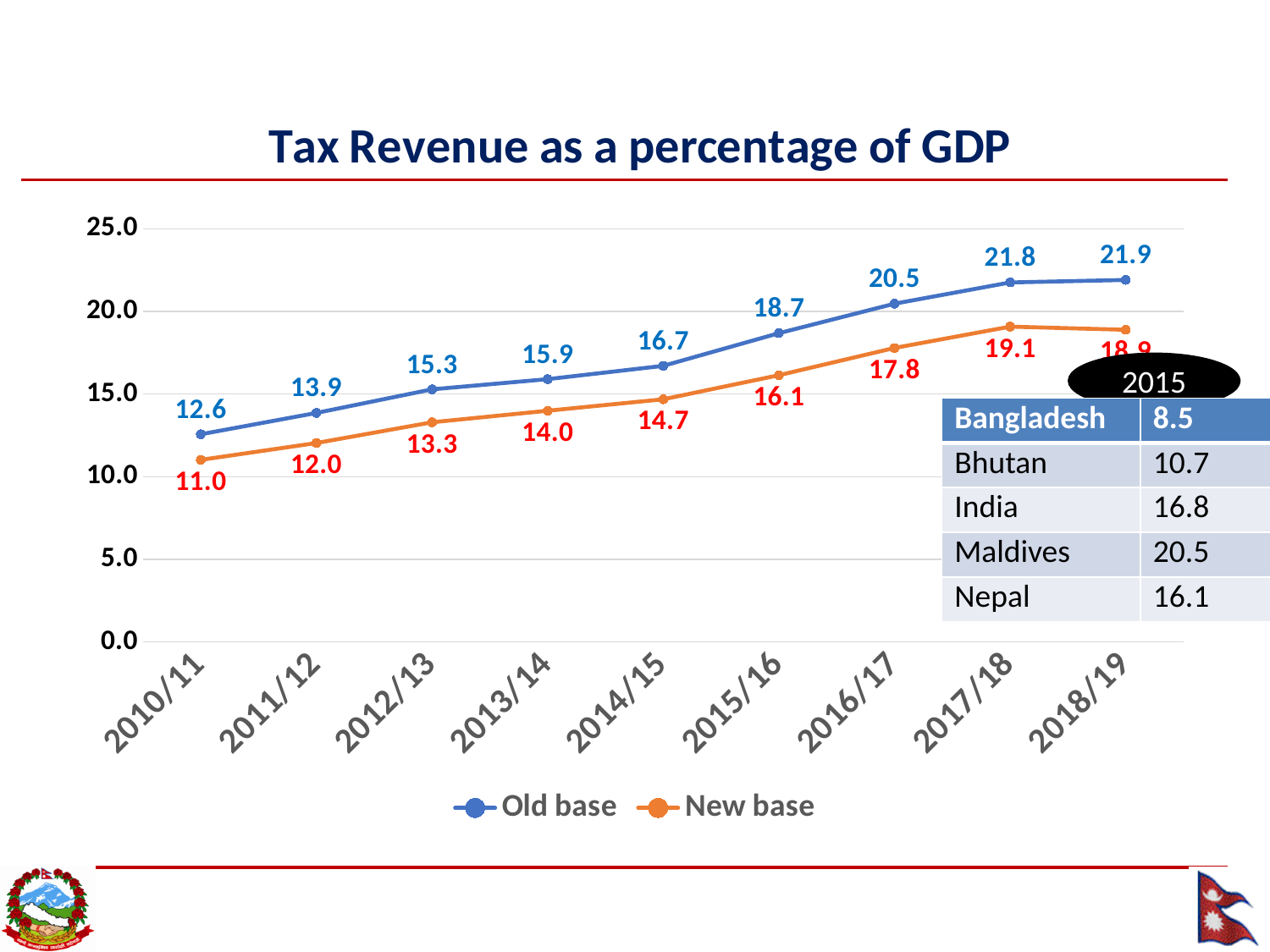
How many fiscal years are plotted along the x axis? 9 What is the New base value for 2015/16? 16.1 In which fiscal year is the Old base value highest? 2018/19 What is the title of the chart? Tax Revenue as a percentage of GDP What is the difference between the Old base and New base values in 2014/15? 2.0 Does the Old base series generally rise or fall from 2010/11 to 2018/19? rise Which is larger in 2017/18, the Old base value or the New base value? Old base In which fiscal year is the New base value lowest? 2010/11 What is the Old base value for 2010/11? 12.6 What is the Old base value for 2016/17? 20.5 What type of chart is shown on the slide? line chart How many series does the chart legend list? 2